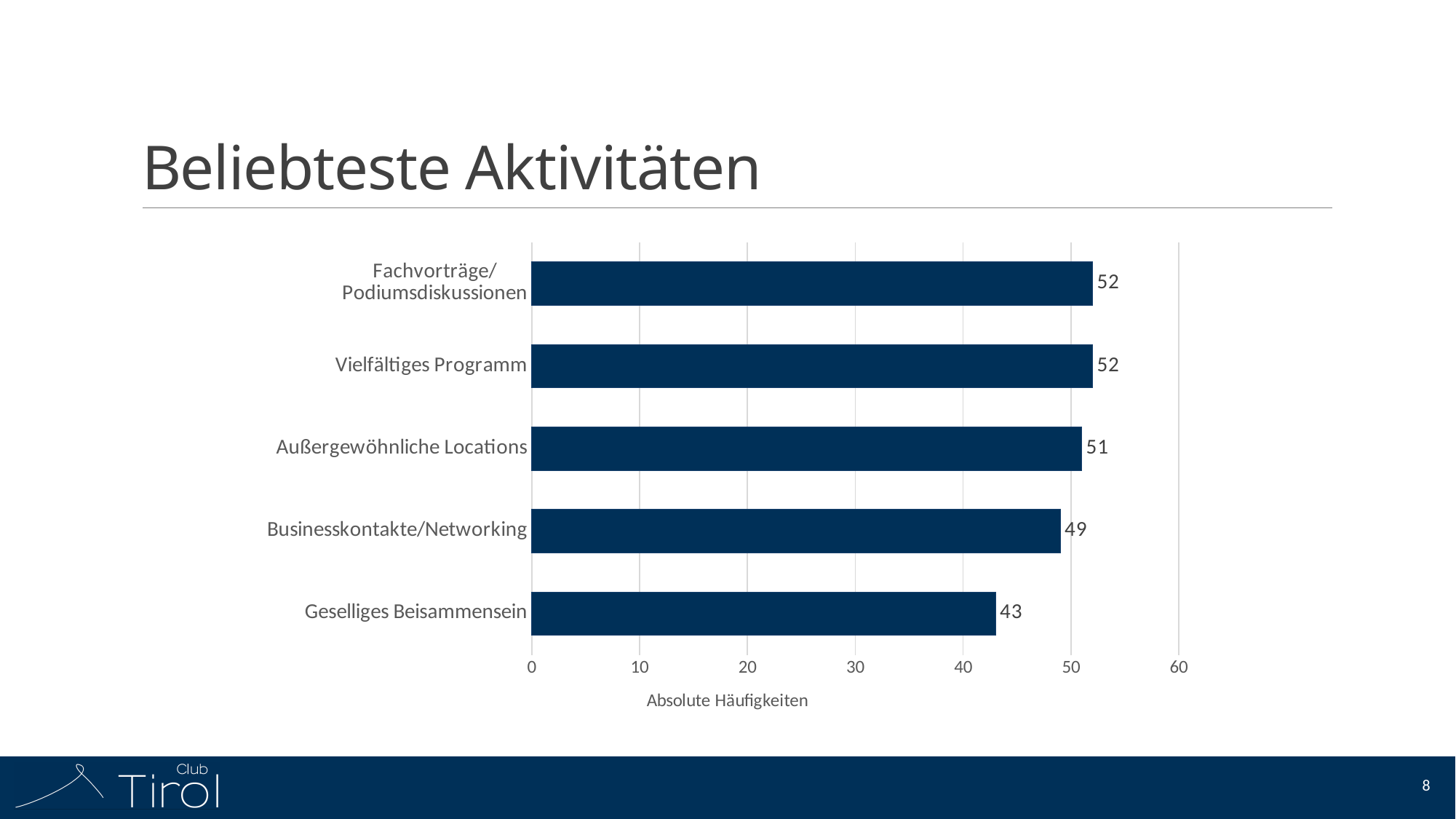
Which is larger, the value for Businesskontakte/Networking or the value for Geselliges Beisammensein? Businesskontakte/Networking What is the difference between the values for Außergewöhnliche Locations and Businesskontakte/Networking? 2 Which category has the lowest value? Geselliges Beisammensein What kind of chart is shown on the slide? bar chart How many categories are shown in the chart? 5 What is the value for Geselliges Beisammensein? 43 What is the value for Businesskontakte/Networking? 49 What is the label of the horizontal axis? Absolute Häufigkeiten What is the value for Vielfältiges Programm? 52 What is the difference between the values for Vielfältiges Programm and Geselliges Beisammensein? 9 Is the value for Geselliges Beisammensein greater or less than 50? less What is the value for Außergewöhnliche Locations? 51